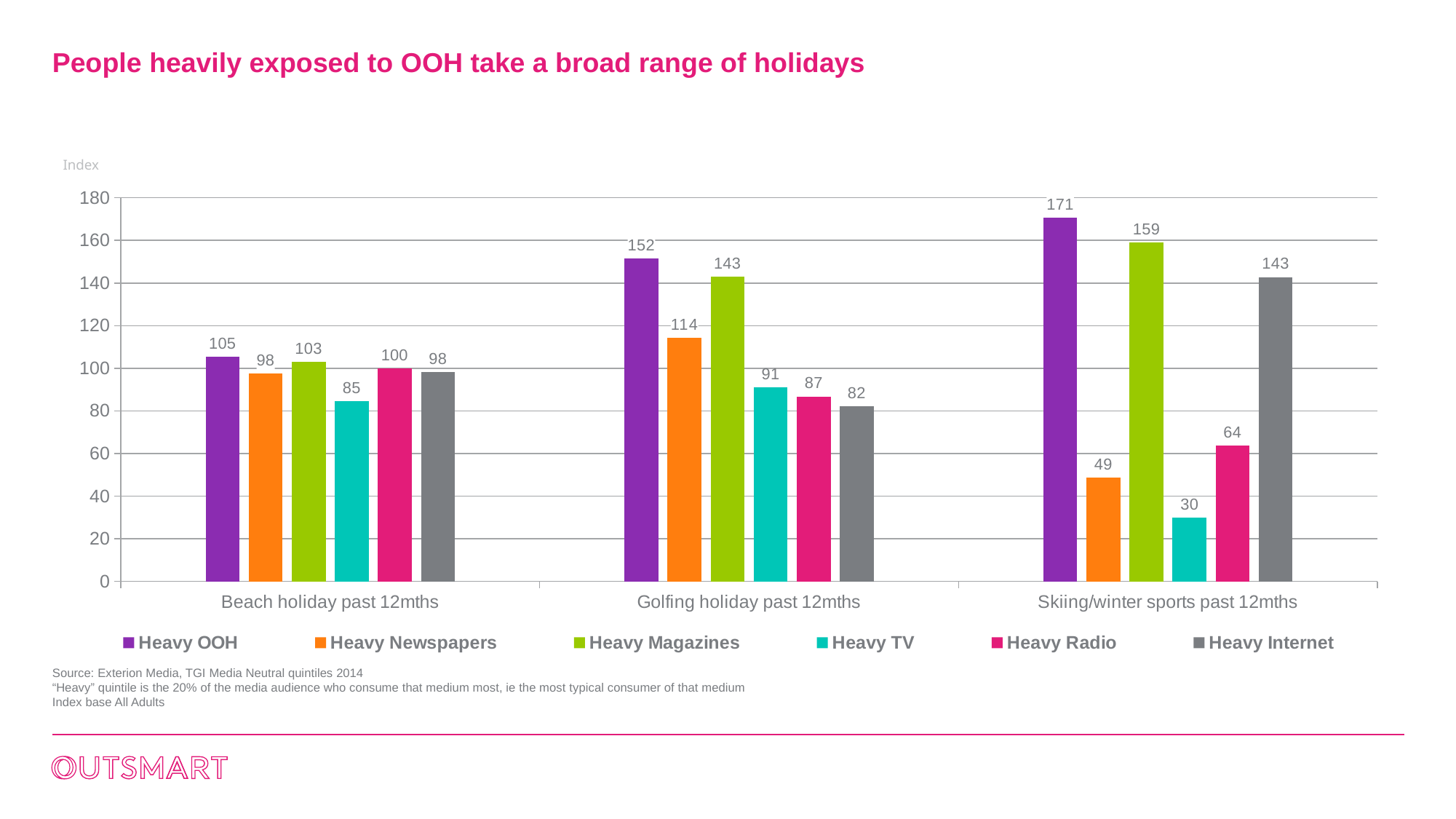
What kind of chart is shown on the slide? Bar chart What is the index value for Heavy Radio for Beach holiday past 12mths? 100 Which series has the highest index for Skiing/winter sports past 12mths? Heavy OOH Which series has the lowest index for Golfing holiday past 12mths? Heavy Internet How many series does the legend list? 6 What is the index value for Heavy TV for Golfing holiday past 12mths? 91 How many holiday categories are shown on the x axis? 3 Which is larger for Golfing holiday past 12mths: Heavy Newspapers or Heavy Magazines? Heavy Magazines What is the label on the vertical axis of the chart? Index What is the difference between the Heavy OOH and Heavy Newspapers index values for Skiing/winter sports past 12mths? 122 Is the Heavy Internet value for Skiing/winter sports past 12mths greater or less than 120? greater What is the index value for Heavy OOH for Skiing/winter sports past 12mths? 171